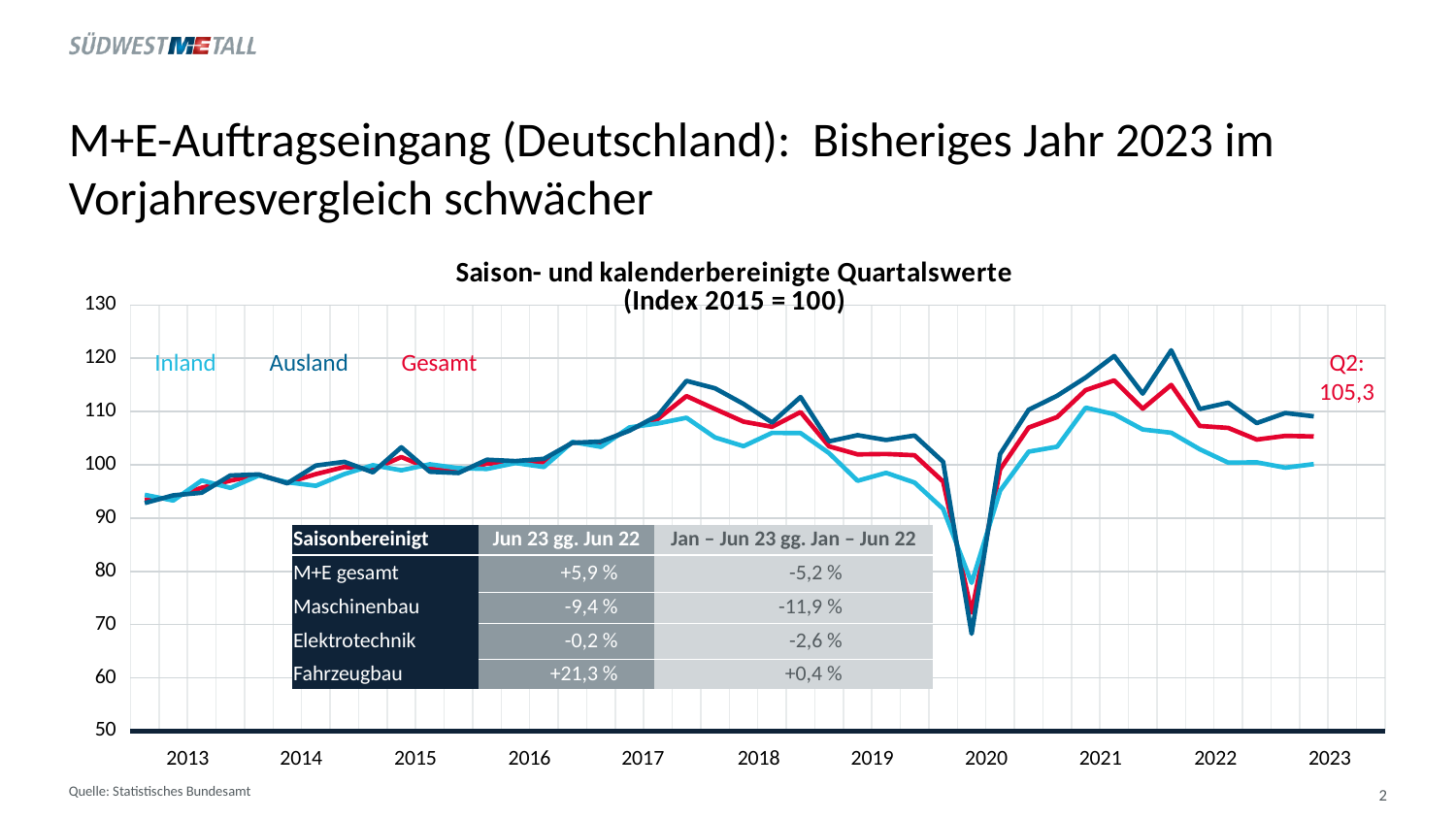
Is the value of the Gesamt series at its 2020 low greater or less than 80? less What kind of chart is shown on the slide? line chart Is the value of the Inland series at the start of 2013 greater or less than 100? less How many series does the chart's legend list? 3 What value is labelled for Q2 2023 at the end of the Gesamt line? 105,3 Is the value of the Ausland series at its 2021 peak greater or less than 110? greater In 2022, which series is higher, Ausland or Inland? Ausland What is the highest value shown on the vertical axis? 130 In which year do all three series reach their lowest point? 2020 Do the series rise or fall from 2013 to 2017? rise Which series are shown in the chart? Inland, Ausland, Gesamt What is the title of the chart? Saison- und kalenderbereinigte Quartalswerte (Index 2015 = 100)